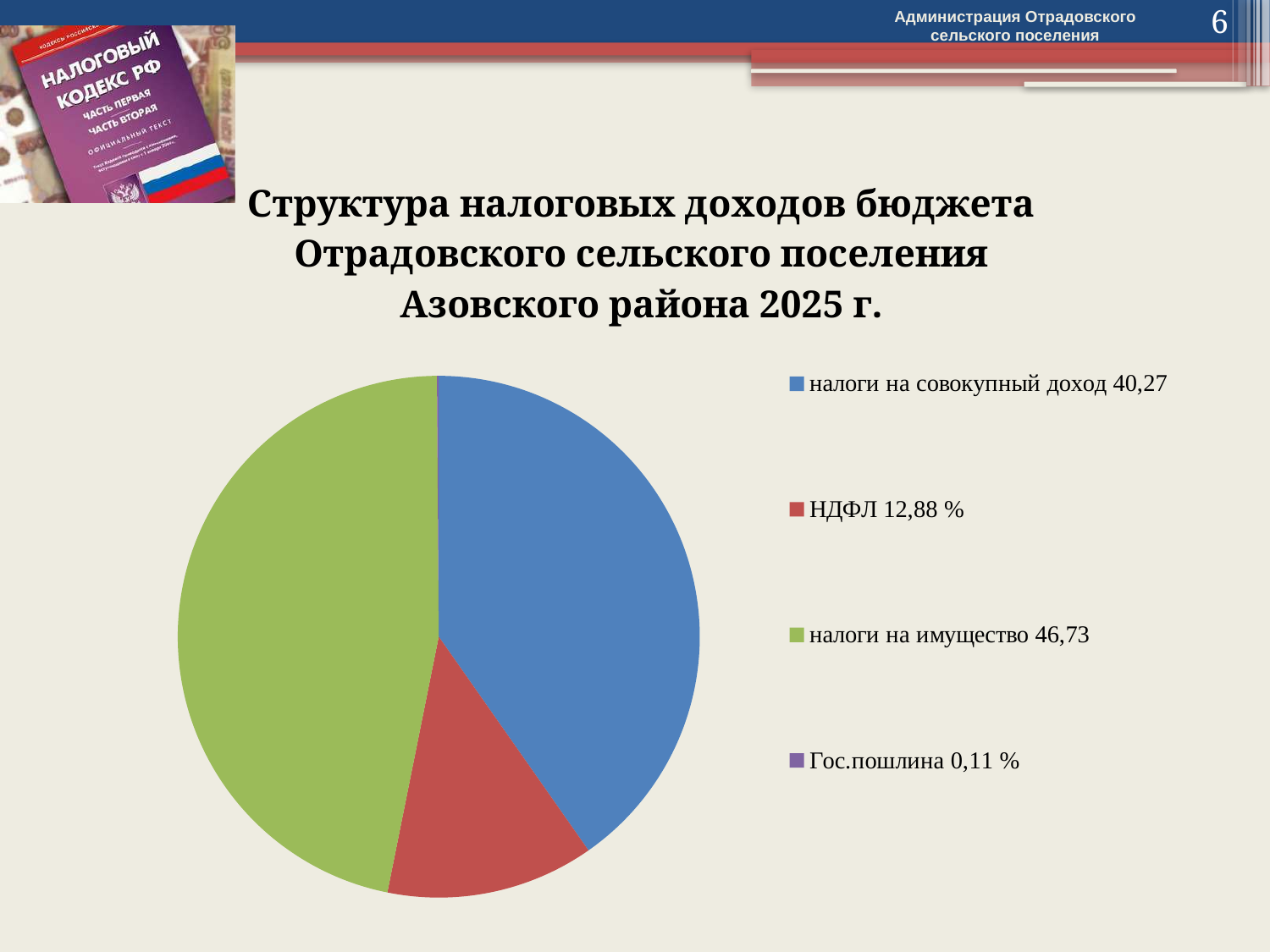
What value is shown in the legend for «налоги на совокупный доход»? 40,27 What kind of chart is shown on the slide? pie chart Which category has the smallest share of the pie? Гос.пошлина Which is larger, «налоги на совокупный доход» or «НДФЛ»? налоги на совокупный доход What colour is the slice for «НДФЛ»? red How many entries does the legend of the pie chart list? 4 What value is shown in the legend for «налоги на имущество»? 46,73 What is the title of the chart on the slide? Структура налоговых доходов бюджета Отрадовского сельского поселения Азовского района 2025 г. What is the difference between the values for «налоги на имущество» and «налоги на совокупный доход»? 6,46 What value is shown in the legend for «Гос.пошлина»? 0,11 % Which category has the largest share of the pie? налоги на имущество What value is shown in the legend for «НДФЛ»? 12,88 %